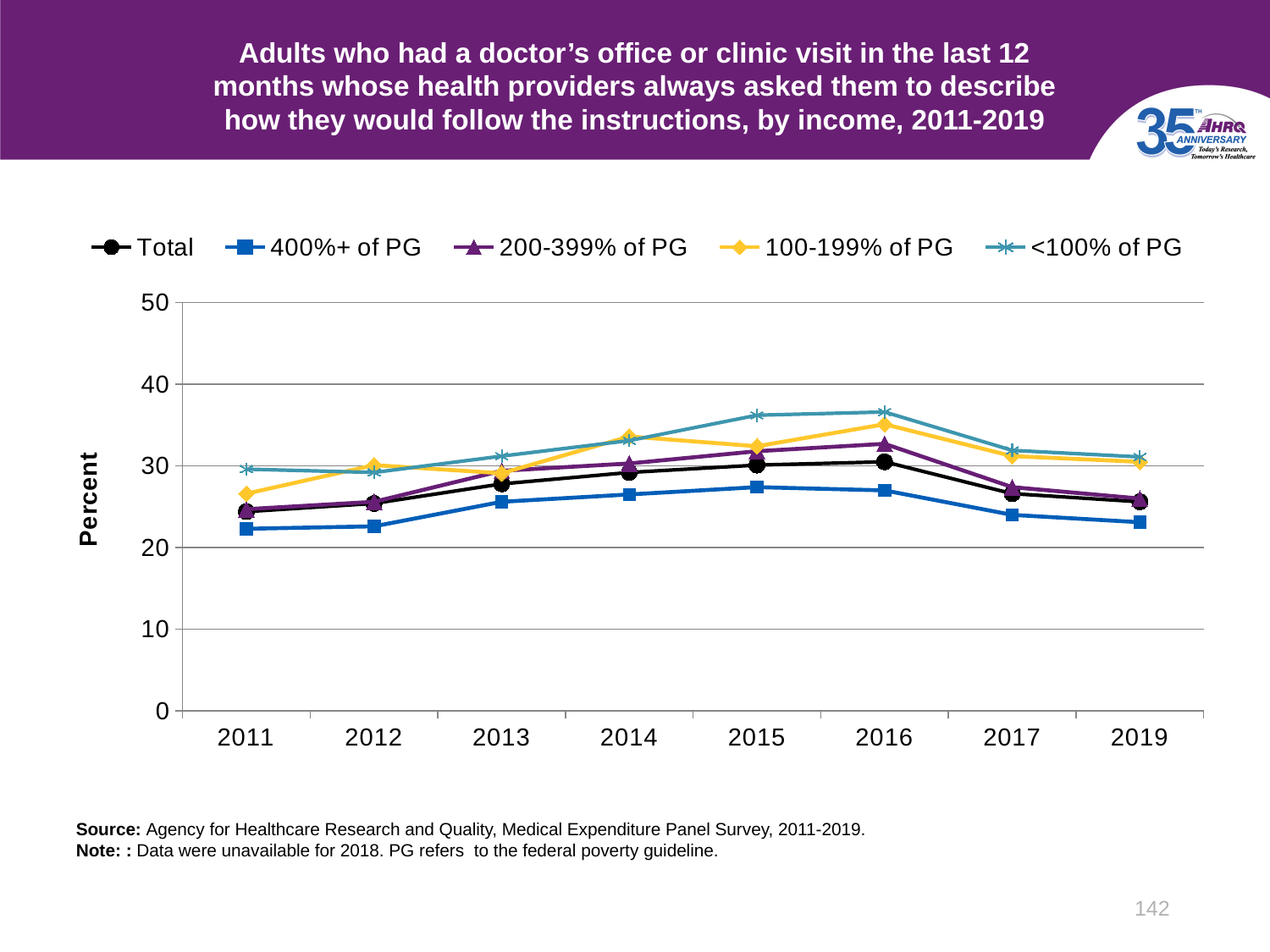
Which income group has the highest value in 2015? <100% of PG Is the value for 400%+ of PG in 2011 greater or less than 30? less What is the label on the y axis? Percent How many years are shown on the x axis? 8 Does the 400%+ of PG series rise or fall from 2016 to 2019? fall Is the value for <100% of PG in 2016 greater or less than 30? greater Which is larger for the Total series: the value in 2016 or the value in 2019? 2016 How many series does the legend list? 5 Which income group has the lowest value in 2019? 400%+ of PG What kind of chart is shown on the slide? line chart Is the value for 100-199% of PG in 2016 greater or less than 30? greater Does the Total series rise or fall from 2011 to 2016? rise